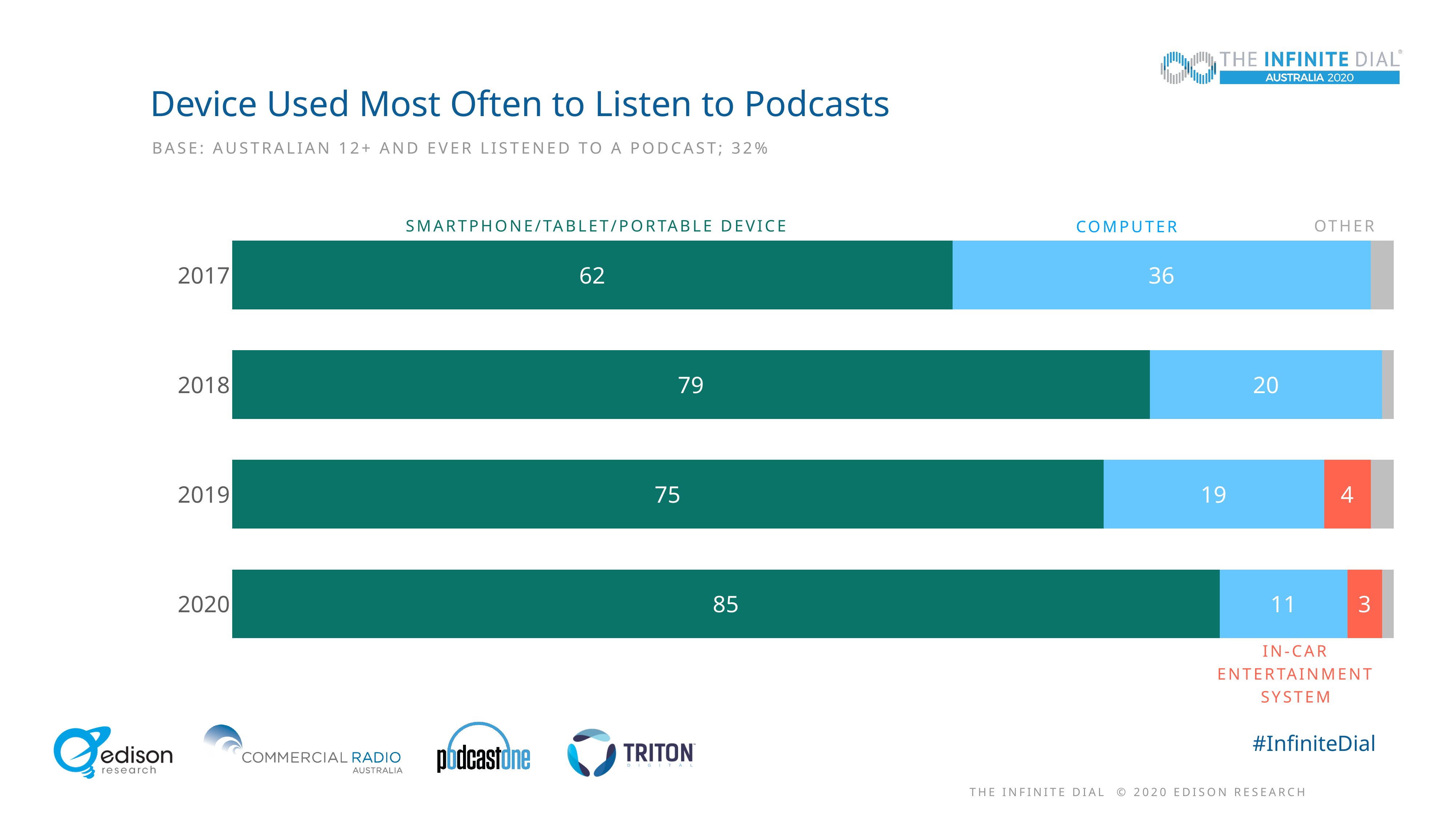
How many years are shown in the chart? 4 What kind of chart is shown on the slide? Stacked bar chart In which year is the Computer value lowest? 2020 What is the difference between the Smartphone/Tablet/Portable Device values for 2020 and 2017? 23 How many device categories does the chart's legend list? 4 What is the value for Smartphone/Tablet/Portable Device in 2017? 62 In which year is the Smartphone/Tablet/Portable Device value highest? 2020 Which is larger: the Smartphone/Tablet/Portable Device value in 2018 or in 2019? 2018 What is the value for Computer in 2020? 11 What is the value for Computer in 2018? 20 What is the value for In-Car Entertainment System in 2019? 4 What is the difference between the Computer values for 2017 and 2018? 16